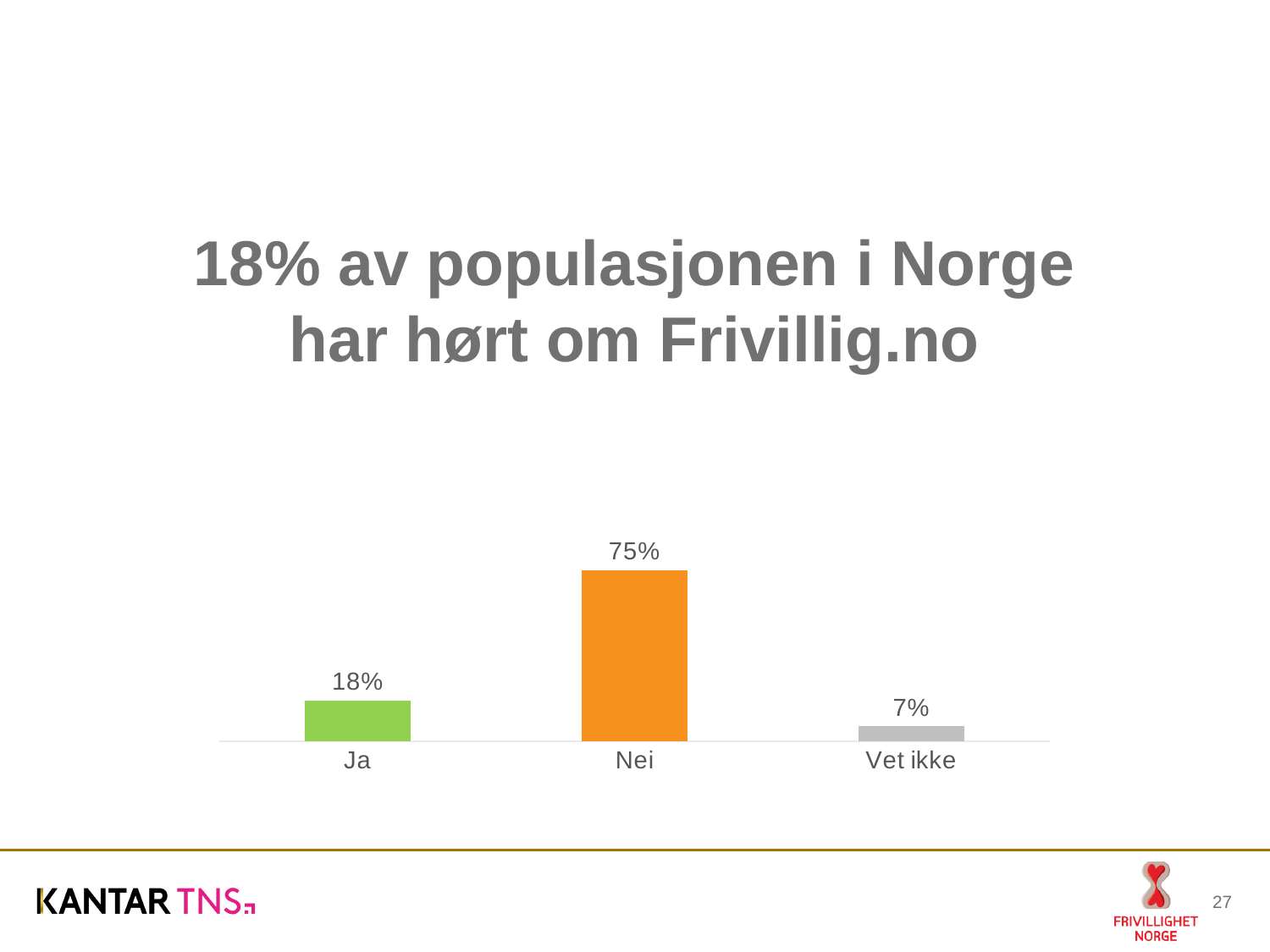
What is the value for Nei? 75% How many categories are shown in the chart? 3 What kind of chart is shown on the slide? Bar chart What is the value for Vet ikke? 7% What colour is the bar for Nei? Orange Which is larger, the value for Ja or the value for Vet ikke? Ja What is the value for Ja? 18% What is the difference between the values for Nei and Ja? 57% What is the difference between the values for Ja and Vet ikke? 11% What colour is the bar for Ja? Green Which category has the highest value? Nei Which category has the lowest value? Vet ikke